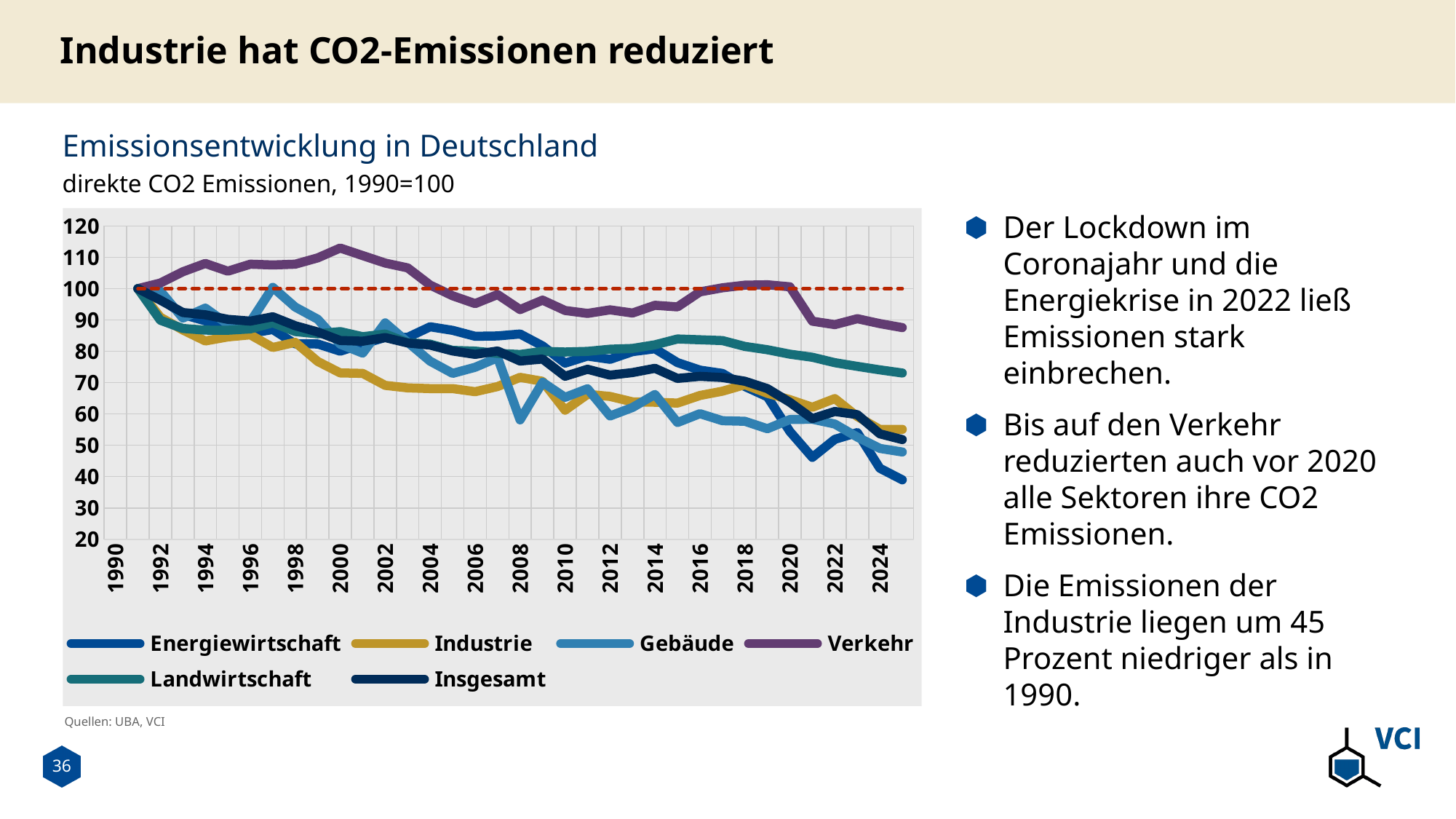
What is the title of the chart? Emissionsentwicklung in Deutschland At what value on the y axis is the red dashed horizontal line drawn? 100 How many series does the chart legend list? 6 Which series has the highest value in 2024? Verkehr What kind of chart is shown on the slide? line chart Is the value for Landwirtschaft in 2024 greater or less than 70? greater What is the index value of Industrie in 1990? 100 Is the value for Industrie in 2024 greater or less than 60? less Is the value for Verkehr in 2000 greater or less than 110? greater Which series has the lowest value in 2024? Energiewirtschaft In 2024, which is larger: the value for Verkehr or the value for Industrie? Verkehr Does the Energiewirtschaft series rise or fall overall from 1990 to 2024? fall